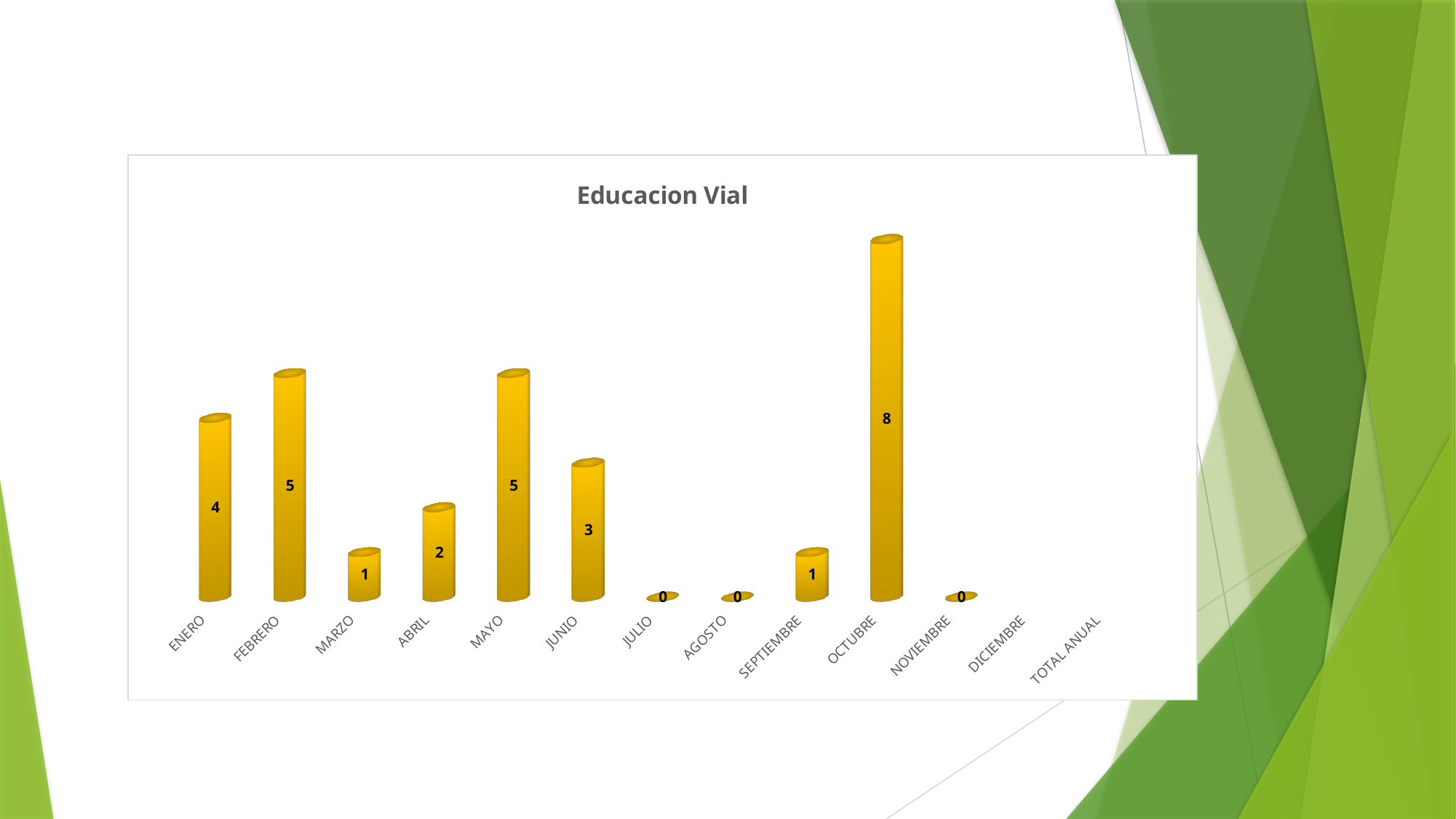
What is the value for ABRIL? 2 How many category labels appear on the x axis? 13 What is the value for OCTUBRE? 8 Which month has the highest value? OCTUBRE What type of chart is shown on the slide? bar chart How many months show a value of 0? 3 Which is larger, the value for ENERO or the value for JUNIO? ENERO What is the title of the chart? Educacion Vial What is the value for ENERO? 4 What is the difference between the values for FEBRERO and MARZO? 4 What is the difference between the values for OCTUBRE and ENERO? 4 What is the value for JUNIO? 3